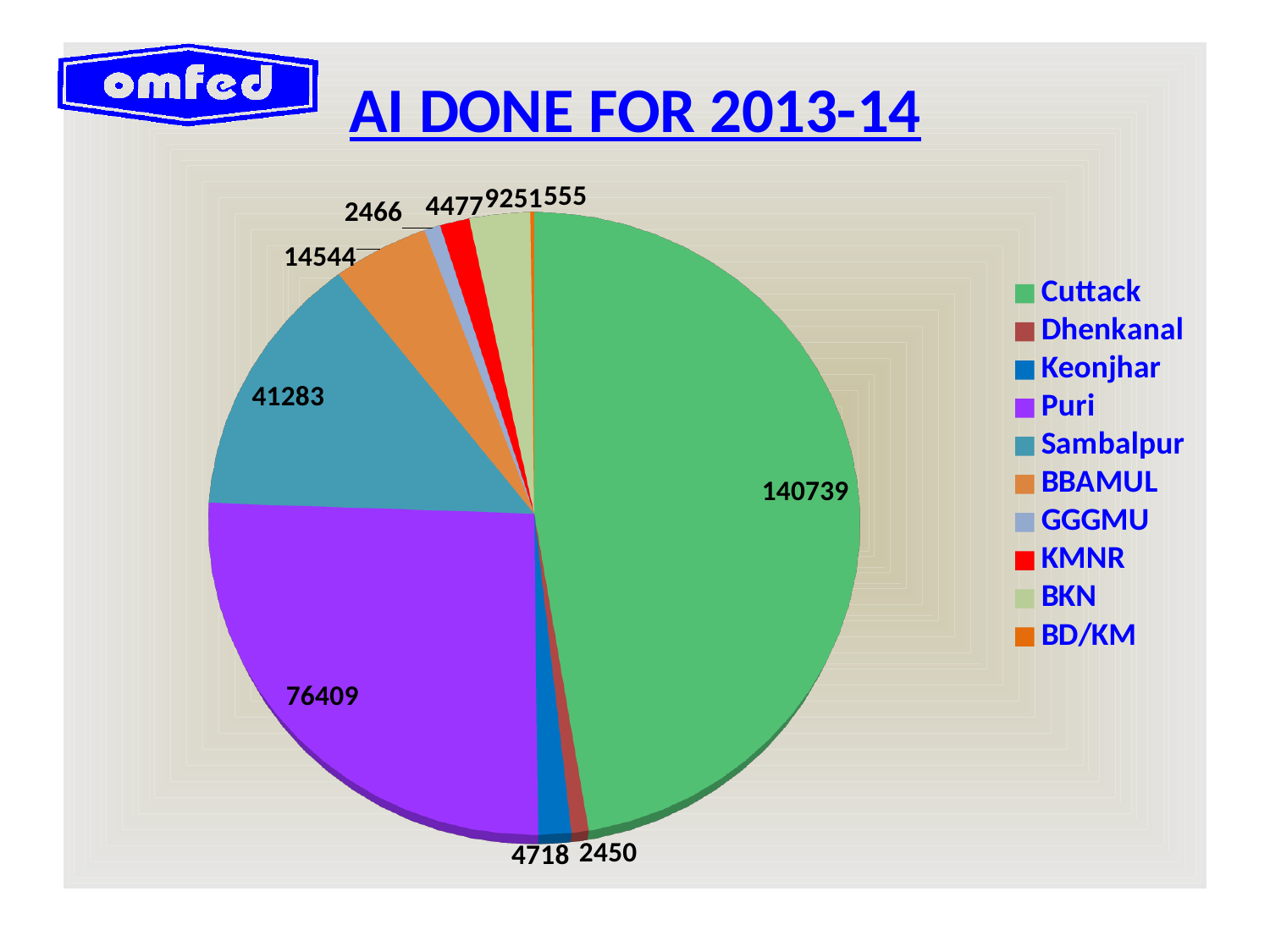
What is the difference between the values for Cuttack and Puri? 64330 What is the difference between the values for Puri and Sambalpur? 35126 Which category has the largest slice of the pie? Cuttack What is the value for BBAMUL? 14544 How many categories does the legend of the pie chart list? 10 What is the value for Cuttack? 140739 What is the value for Sambalpur? 41283 Which category has the smallest slice of the pie? BD/KM What type of chart is shown on the slide? pie chart What is the title of the chart? AI DONE FOR 2013-14 What is the value for Puri? 76409 Which is larger, the value for Keonjhar or the value for Dhenkanal? Keonjhar